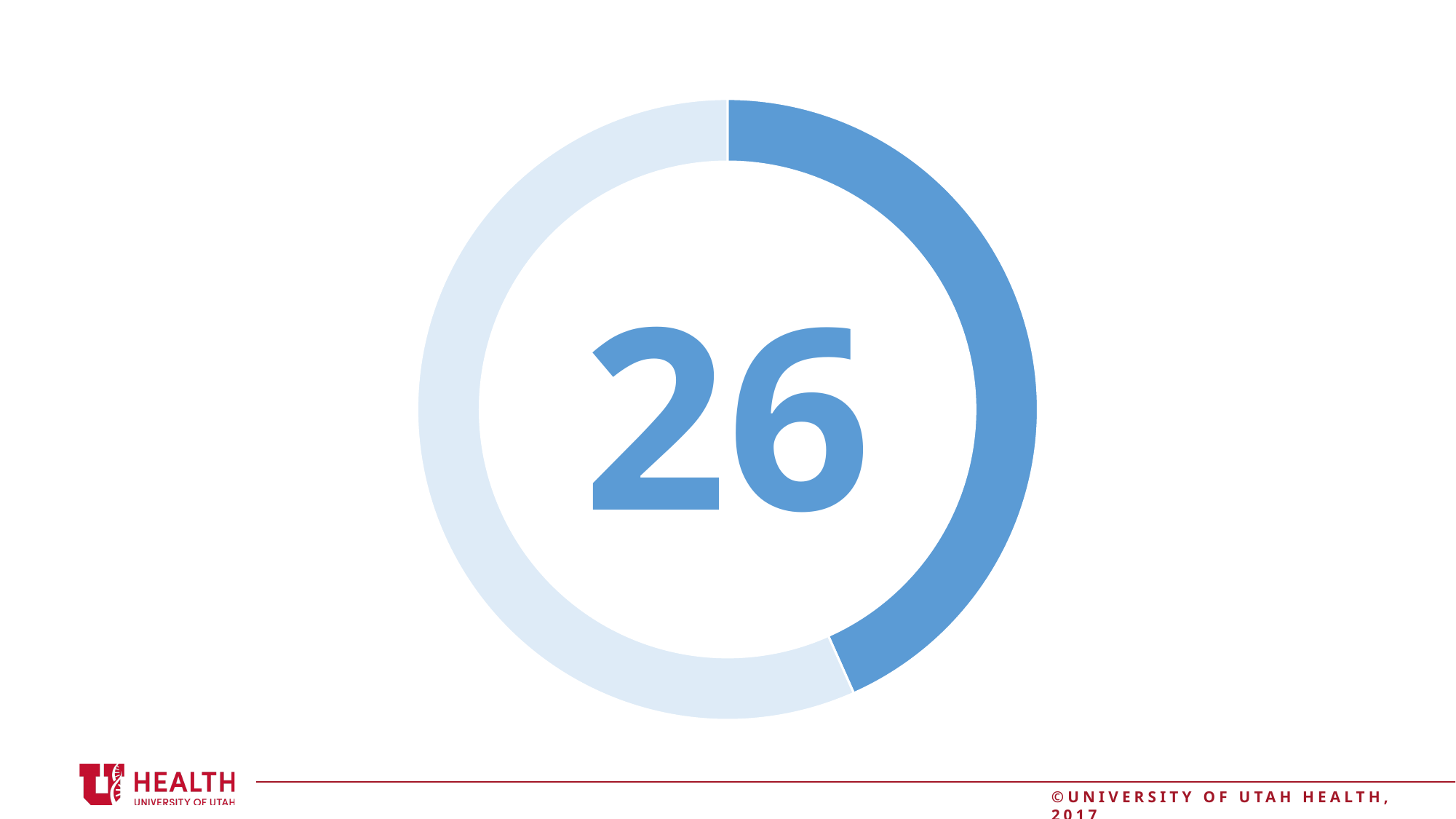
Does the dark blue segment cover more or less than half of the ring? Less What two colours are used for the segments of the donut chart? Dark blue and light blue What number is printed in the center of the donut chart? 26 How many segments does the donut chart have? 2 Which segment of the donut chart is larger, the dark blue one or the light blue one? The light blue one What kind of chart is shown on the slide? Donut chart Does the donut chart have a legend? No